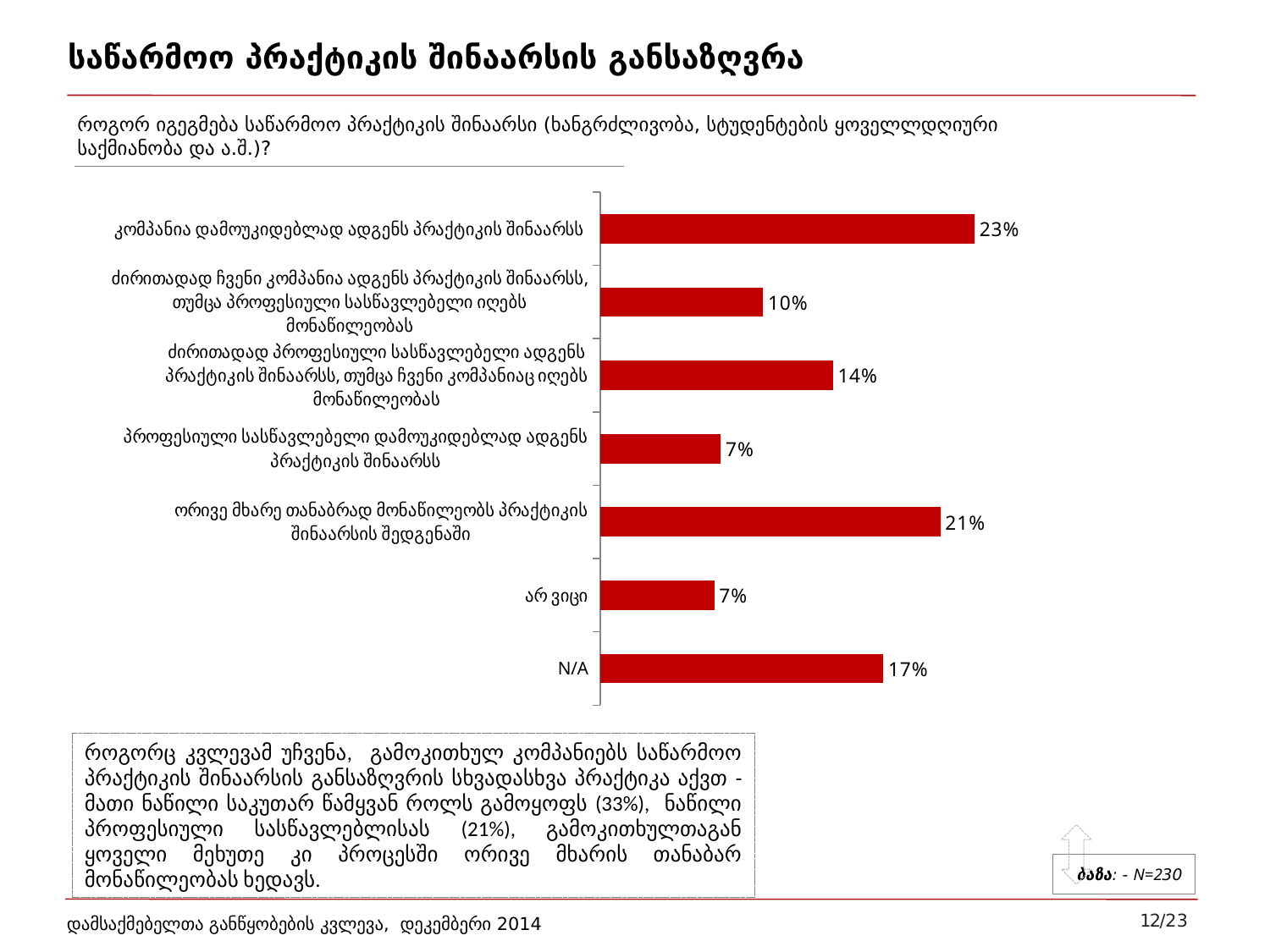
What is the value for "არ ვიცი"? 7% Which is larger: the value for "ძირითადად ჩვენი კომპანია ადგენს პრაქტიკის შინაარსს, თუმცა პროფესიული სასწავლებელი იღებს მონაწილეობას" or the value for "ძირითადად პროფესიული სასწავლებელი ადგენს პრაქტიკის შინაარსს, თუმცა ჩვენი კომპანიაც იღებს მონაწილეობას"? ძირითადად პროფესიული სასწავლებელი ადგენს პრაქტიკის შინაარსს, თუმცა ჩვენი კომპანიაც იღებს მონაწილეობას How many categories are plotted in the chart? 7 What colour are the bars in the chart? red Which category has the highest value? კომპანია დამოუკიდებლად ადგენს პრაქტიკის შინაარსს What is the value for "პროფესიული სასწავლებელი დამოუკიდებლად ადგენს პრაქტიკის შინაარსს"? 7% What is the value for "N/A"? 17% What is the value for "ორივე მხარე თანაბრად მონაწილეობს პრაქტიკის შინაარსის შედგენაში"? 21% What is the difference between the value for "კომპანია დამოუკიდებლად ადგენს პრაქტიკის შინაარსს" and the value for "N/A"? 6% What type of chart is shown on the slide? bar chart What is the value for "კომპანია დამოუკიდებლად ადგენს პრაქტიკის შინაარსს"? 23% What is the difference between the value for "ორივე მხარე თანაბრად მონაწილეობს პრაქტიკის შინაარსის შედგენაში" and the value for "არ ვიცი"? 14%